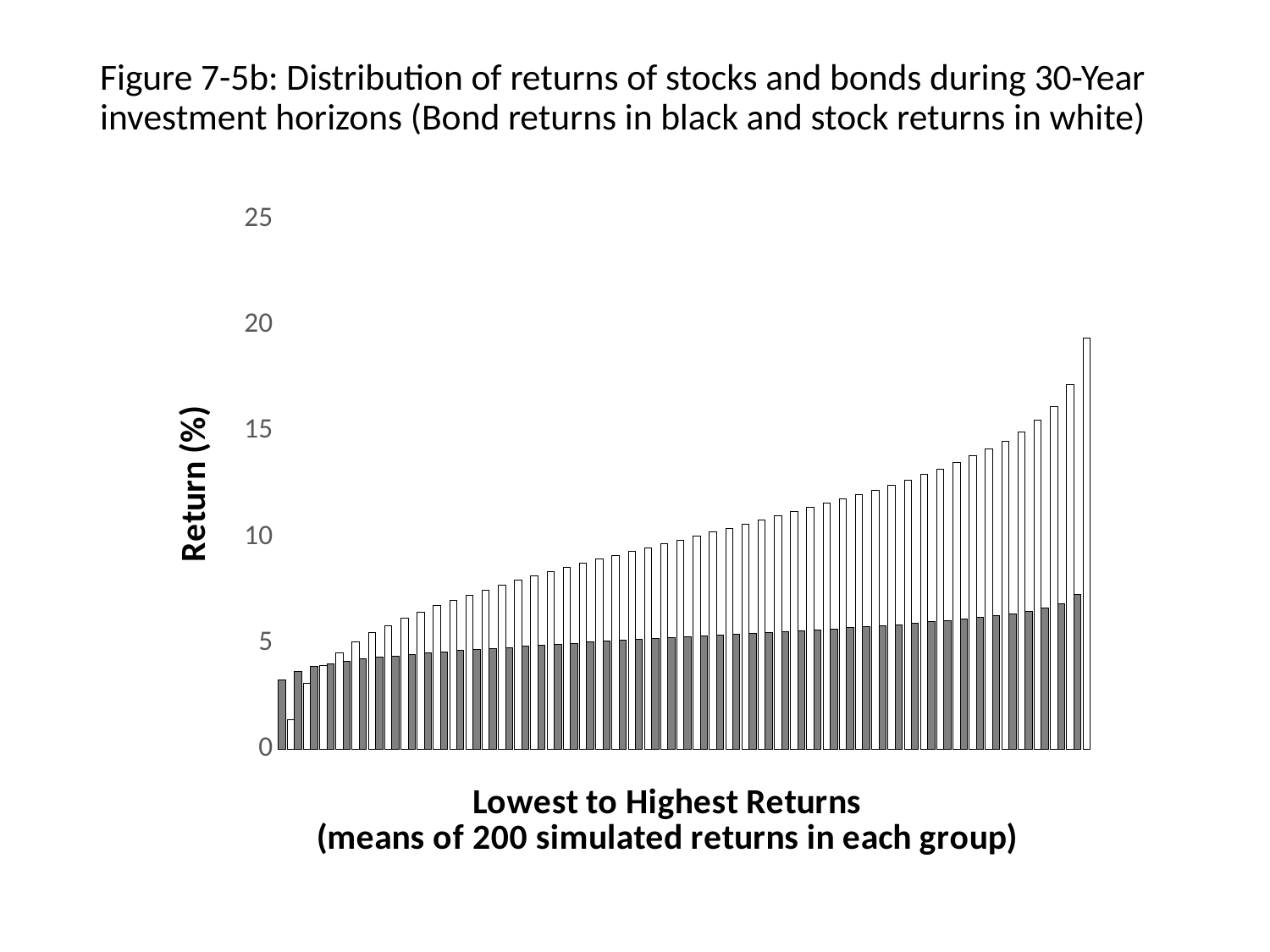
What is the label of the vertical axis? Return (%) Is the tallest white (stock return) bar greater or less than 15? greater Is the tallest black (bond return) bar greater or less than 10? less Is the tallest white (stock return) bar greater or less than 20? less At the right end of the chart, which is larger: the white (stock) bar or the black (bond) bar? the white (stock) bar What is the title of the chart? Figure 7-5b: Distribution of returns of stocks and bonds during 30-Year investment horizons (Bond returns in black and stock returns in white) What is the highest value shown on the vertical axis? 25 What kind of chart is shown on the slide? bar chart Do the black (bond return) bars rise or fall from left to right along the x axis? rise Do the white (stock return) bars rise or fall from left to right along the x axis? rise